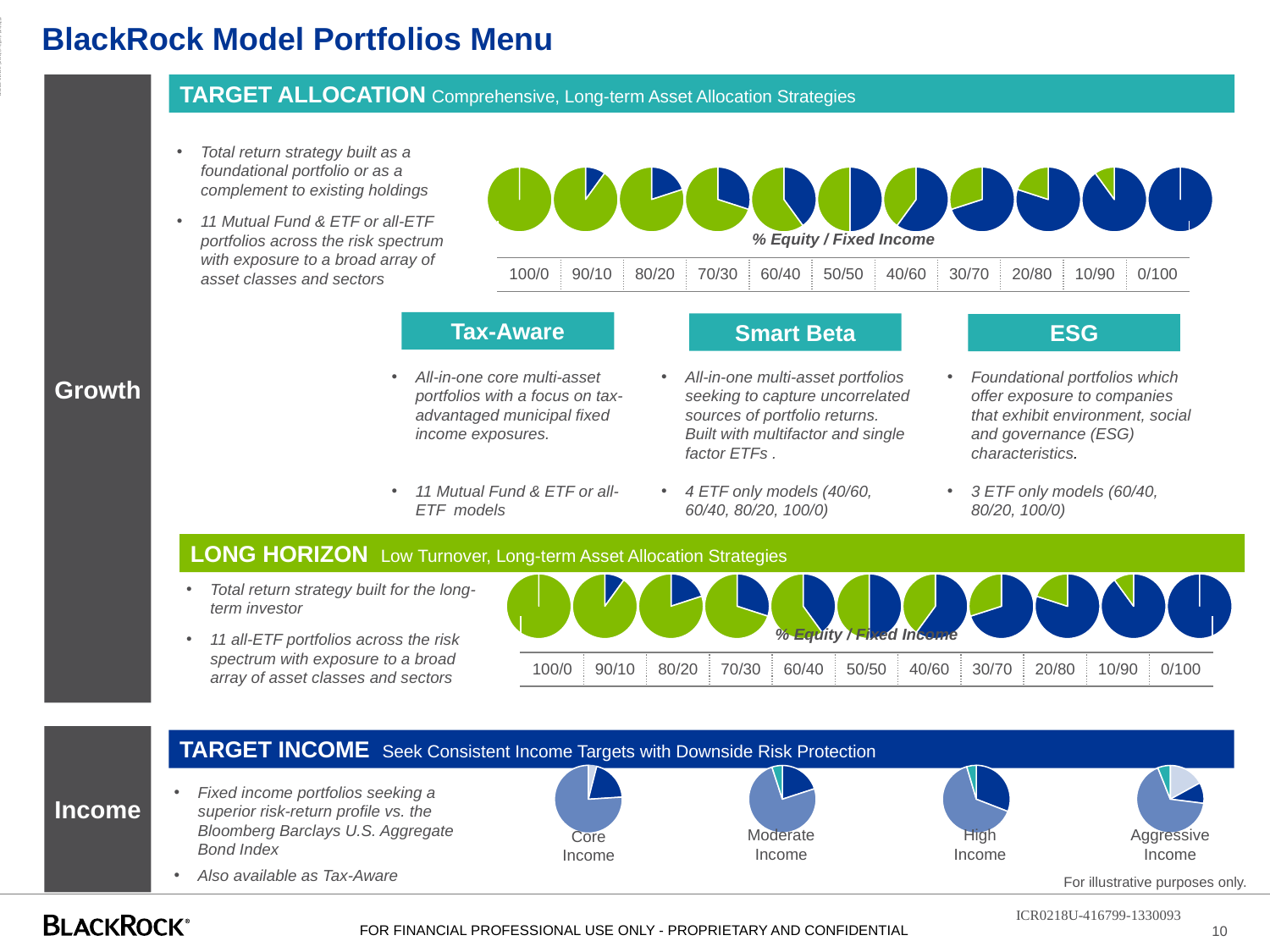
How many pie charts are shown in the Long Horizon row? 11 In the Target Allocation row, what is the equity/fixed income split labelled under the sixth pie chart? 50/50 How many pie charts are shown in the Target Income row? 4 In the Target Allocation row, what is the equity/fixed income split labelled under the first (leftmost) pie chart? 100/0 How many pie charts are shown in the Target Allocation row? 11 What kind of charts are shown in the Target Allocation row? Pie charts What are the labels of the four pie charts in the Target Income row? Core Income, Moderate Income, High Income, Aggressive Income Moving from left to right along the Target Allocation row of pie charts, does the equity share rise or fall? Fall In the Target Allocation row, which pie chart has the highest equity allocation? 100/0 In the Target Allocation row, which pie chart has the lowest equity allocation? 0/100 In the Target Allocation row, which pie has the larger equity share, the 80/20 pie or the 30/70 pie? 80/20 In the Long Horizon row, what is the equity/fixed income split labelled under the last (rightmost) pie chart? 0/100